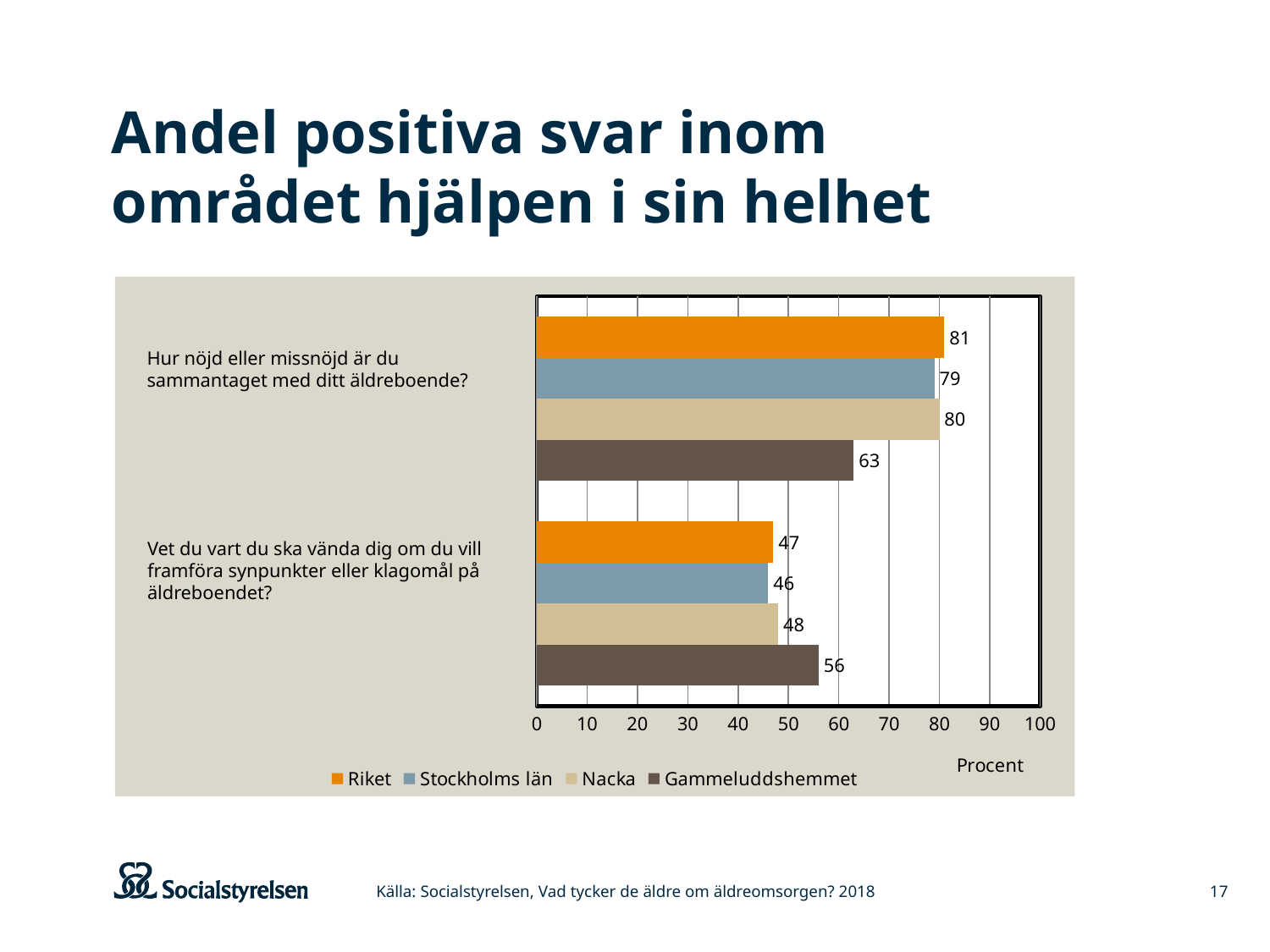
What kind of chart is shown on the slide? Bar chart What is the value for Gammeluddshemmet on the question "Vet du vart du ska vända dig om du vill framföra synpunkter eller klagomål på äldreboendet?"? 56 How many series does the legend list? 4 What is the difference between Riket and Gammeluddshemmet on the question "Hur nöjd eller missnöjd är du sammantaget med ditt äldreboende?"? 18 What is the value for Stockholms län on the question "Vet du vart du ska vända dig om du vill framföra synpunkter eller klagomål på äldreboendet?"? 46 What is the value for Nacka on the question "Hur nöjd eller missnöjd är du sammantaget med ditt äldreboende?"? 80 What is the value for Riket on the question "Hur nöjd eller missnöjd är du sammantaget med ditt äldreboende?"? 81 Which series has the highest value on the question "Vet du vart du ska vända dig om du vill framföra synpunkter eller klagomål på äldreboendet?"? Gammeluddshemmet Which is larger on the question "Vet du vart du ska vända dig om du vill framföra synpunkter eller klagomål på äldreboendet?": Gammeluddshemmet or Nacka? Gammeluddshemmet Which series has the lowest value on the question "Hur nöjd eller missnöjd är du sammantaget med ditt äldreboende?"? Gammeluddshemmet How many questions (categories) are shown on the chart? 2 What is the label on the horizontal axis of the chart? Procent